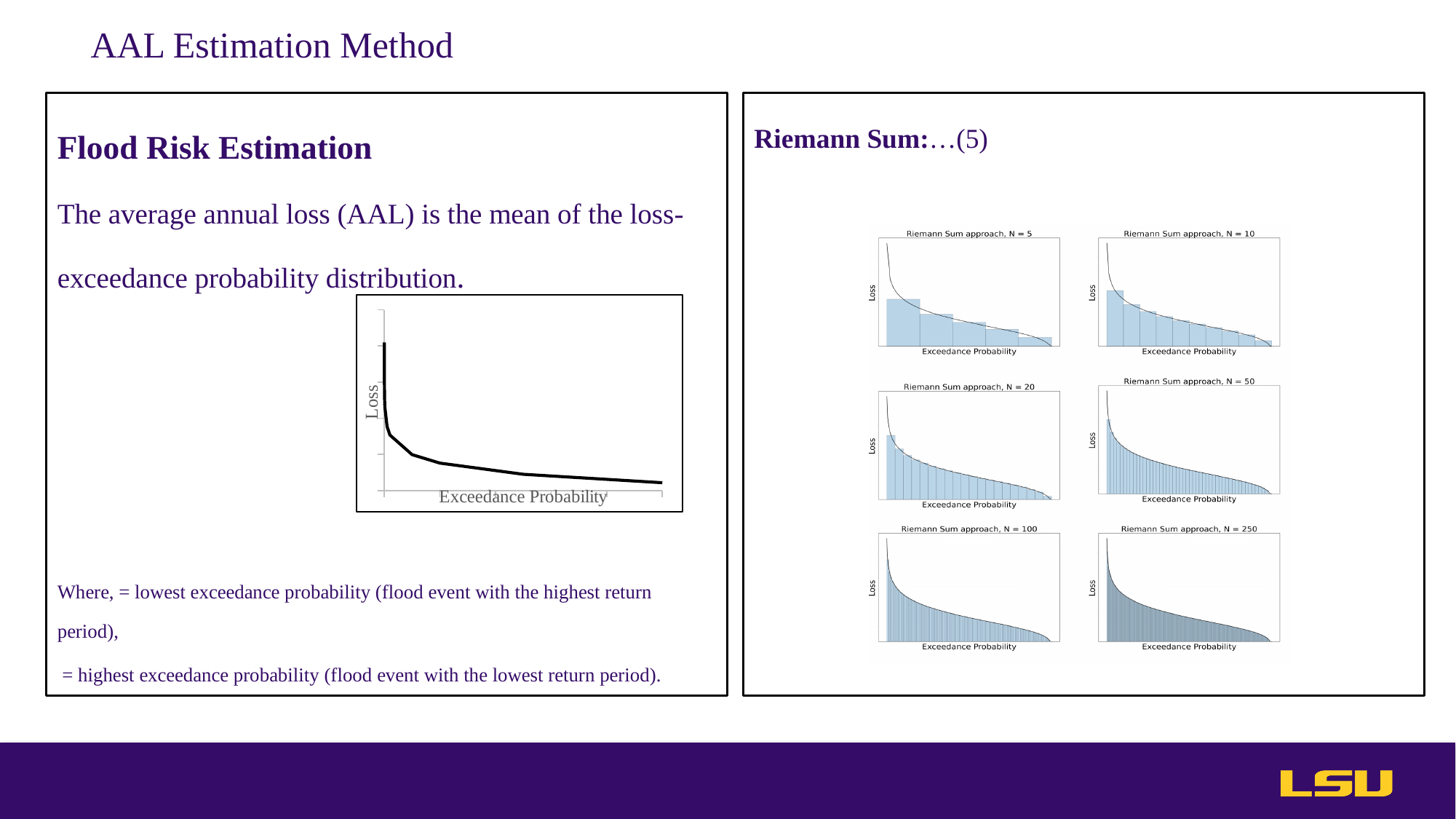
How many small 'Riemann Sum approach' charts are shown in the right panel? 6 In the right panel, how many bars are drawn in the chart titled 'Riemann Sum approach, N = 10'? 10 In the left-panel chart, does Loss rise or fall as Exceedance Probability increases along the x axis? fall What is the x-axis label of the chart titled 'Riemann Sum approach, N = 100'? Exceedance Probability In the right panel, which chart has the smallest value of N in its title? Riemann Sum approach, N = 5 What kind of chart is shown in the left panel under 'Flood Risk Estimation'? line chart In the right panel, which chart has the largest value of N in its title? Riemann Sum approach, N = 250 What is the y-axis label of the left-panel chart? Loss In the chart titled 'Riemann Sum approach, N = 250', does the curve rise or fall along the x axis? fall In the right panel, how many bars are drawn in the chart titled 'Riemann Sum approach, N = 5'? 5